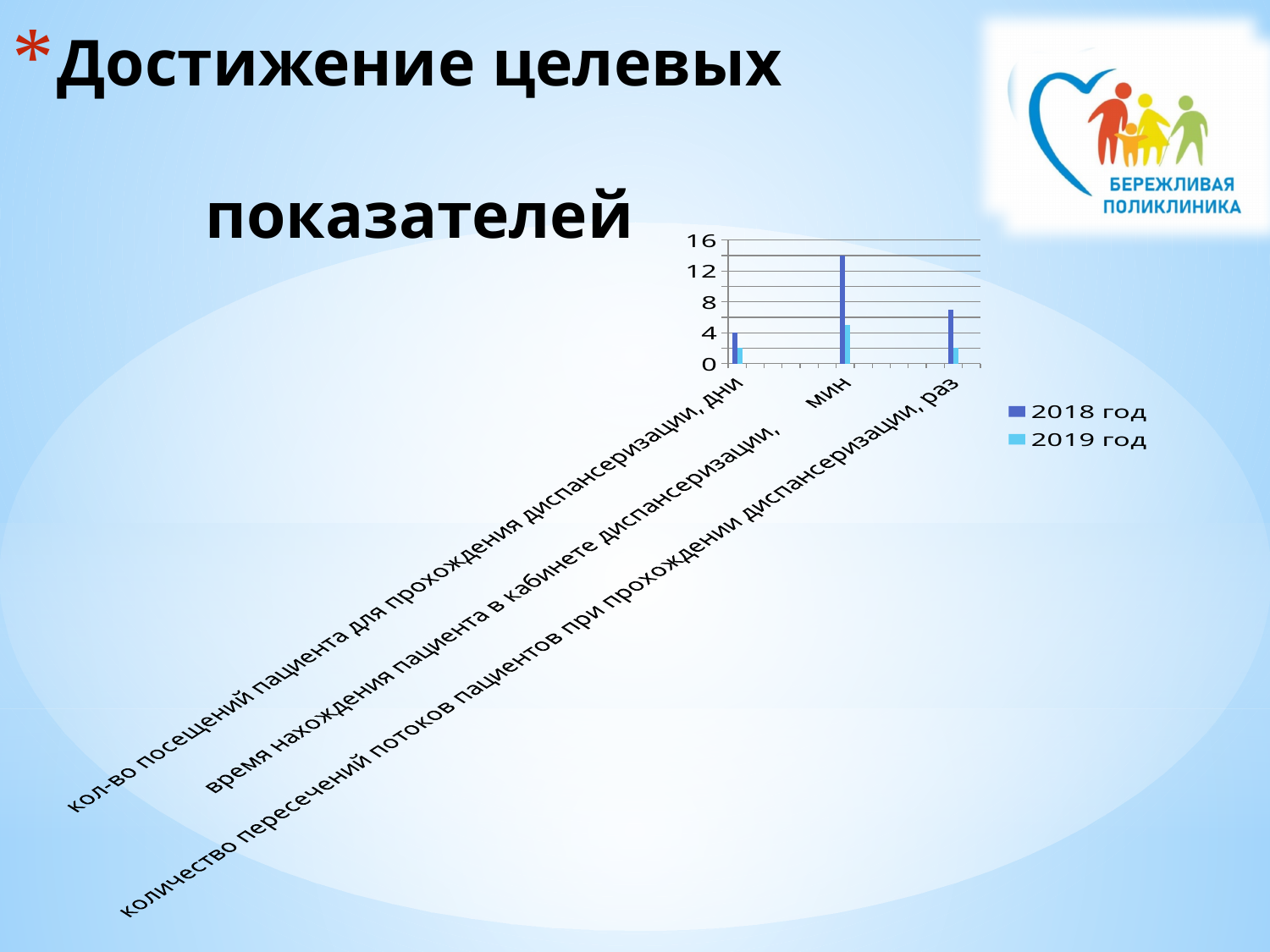
Which category has the highest value for 2018 год? время нахождения пациента в кабинете диспансеризации, мин What kind of chart is shown on the slide? bar chart Which category has the lowest value for 2018 год? кол-во посещений пациента для прохождения диспансеризации, дни How many series does the chart legend list? 2 Is the 2019 год value for количество пересечений потоков пациентов greater or less than 4? less Is the 2018 год value for количество пересечений потоков пациентов greater or less than 4? greater How many categories are shown on the x axis of the chart? 3 Is the 2018 год value for время нахождения пациента в кабинете диспансеризации greater or less than 12? greater Which series are listed in the chart legend? 2018 год, 2019 год For время нахождения пациента в кабинете диспансеризации, which series has the larger value, 2018 год or 2019 год? 2018 год For количество пересечений потоков пациентов, which series has the larger value, 2018 год or 2019 год? 2018 год